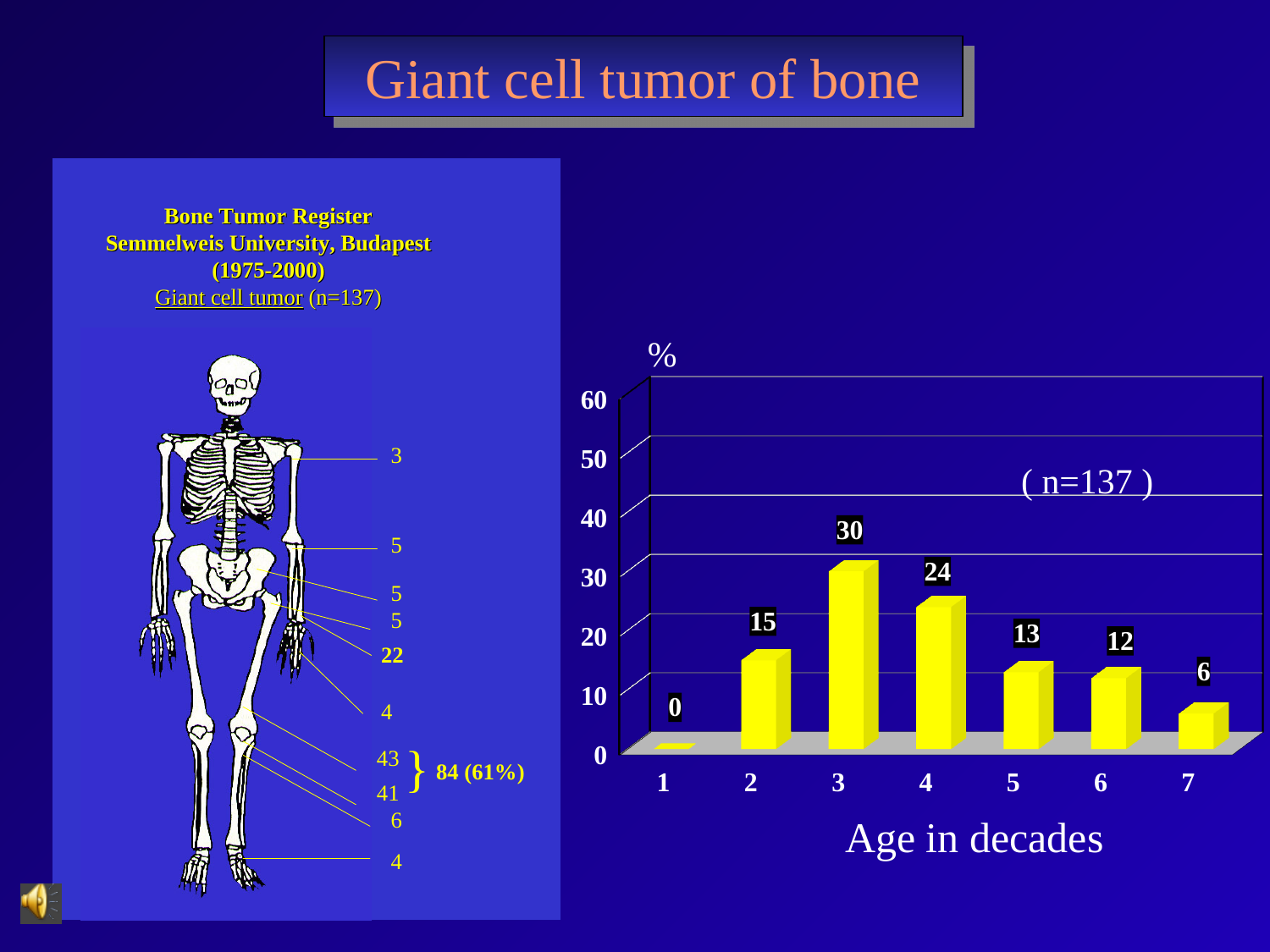
What kind of chart is shown on the right of the slide? bar chart What is the value for age decade 1 in the bar chart? 0 How many age decade categories are shown on the x axis of the bar chart? 7 Which has a larger value in the bar chart, age decade 2 or age decade 6? 2 Is the value for age decade 4 greater or less than 20? greater What is the x-axis label of the bar chart? Age in decades What is the difference between the values for age decades 3 and 4 in the bar chart? 6 Which age decade has the highest value in the bar chart? 3 What is the value for age decade 3 in the bar chart? 30 What is the value for age decade 5 in the bar chart? 13 Which age decade has the lowest value in the bar chart? 1 Do the values in the bar chart rise or fall from age decade 3 to age decade 7? fall